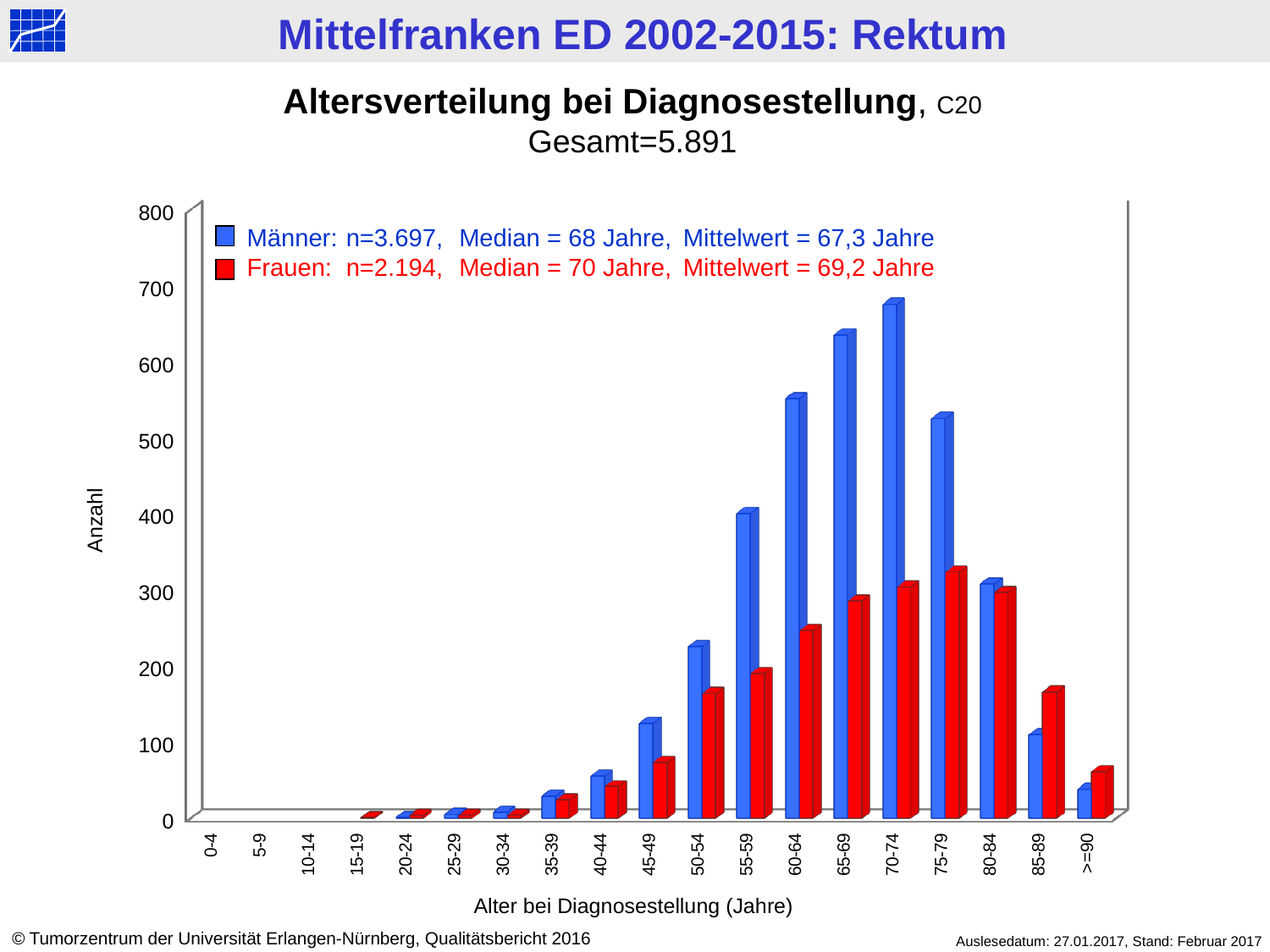
Is the Frauen value for 50-54 greater or less than 200? less Do the Männer values rise or fall from 35-39 to 70-74? rise According to the legend, what is the median age for Frauen? 70 Jahre How many series does the legend list? 2 Is the Männer value for 60-64 greater or less than 500? greater What kind of chart is shown on the slide? bar chart Is the Männer value for 45-49 greater or less than 100? greater How many age categories are shown on the x axis? 19 For the 60-64 age group, which series has the larger value, Männer or Frauen? Männer In which age group is the Männer value highest? 70-74 For the 85-89 age group, which series has the larger value, Männer or Frauen? Frauen